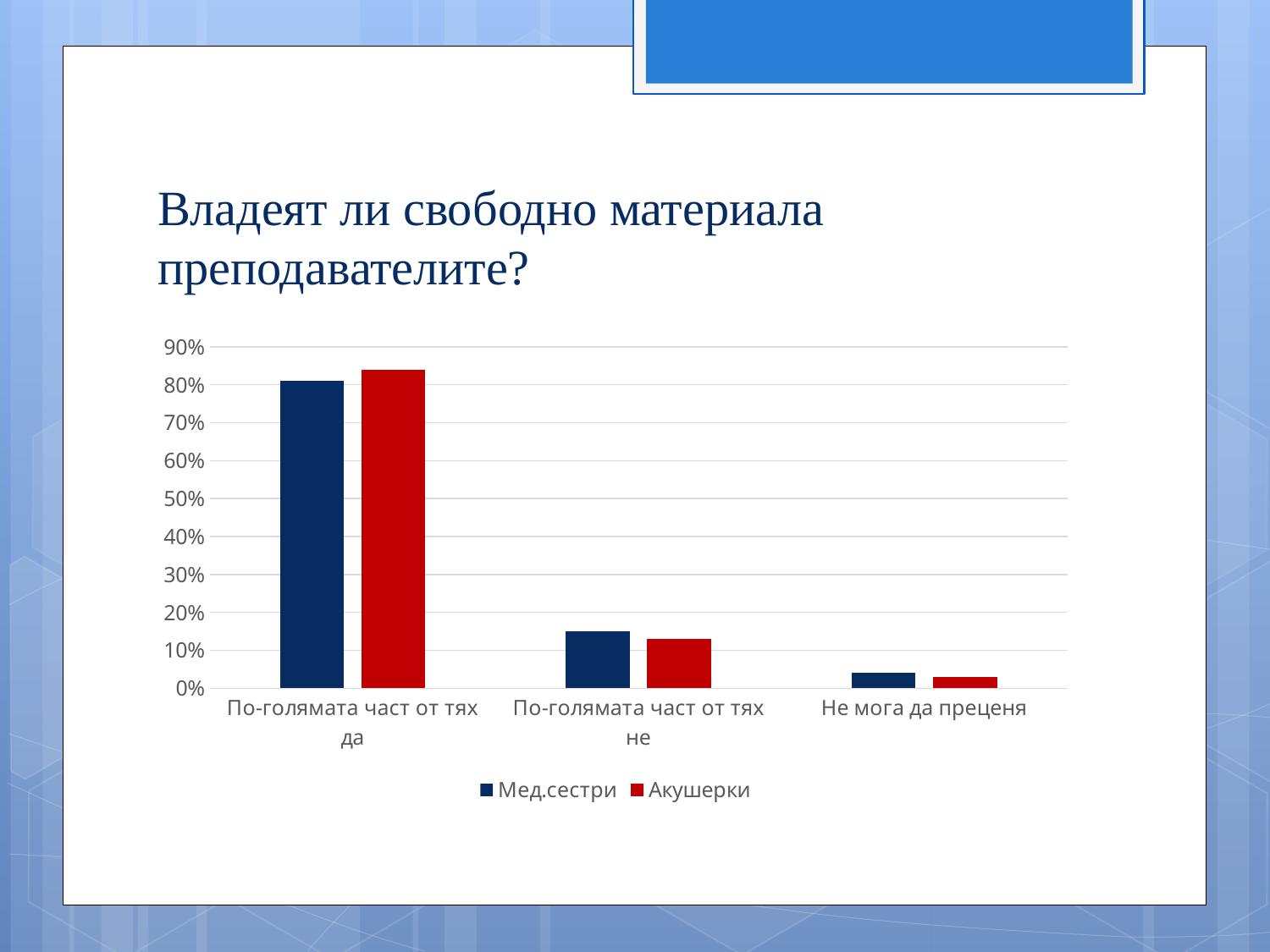
Is the value for Акушерки in the category 'По-голямата част от тях да' greater or less than 80%? greater How many categories are shown on the x axis? 3 What is the title of the chart? Владеят ли свободно материала преподавателите? Which colour represents the Акушерки series in the legend? red Is the value for Мед.сестри in the category 'По-голямата част от тях да' greater or less than 70%? greater Which category has the lowest value for Акушерки? Не мога да преценя In the category 'По-голямата част от тях да', which series has the larger value, Мед.сестри or Акушерки? Акушерки Is the value for Акушерки in the category 'По-голямата част от тях не' greater or less than 20%? less How many series does the legend list? 2 What kind of chart is shown on the slide? bar chart Which category has the highest value for Мед.сестри? По-голямата част от тях да